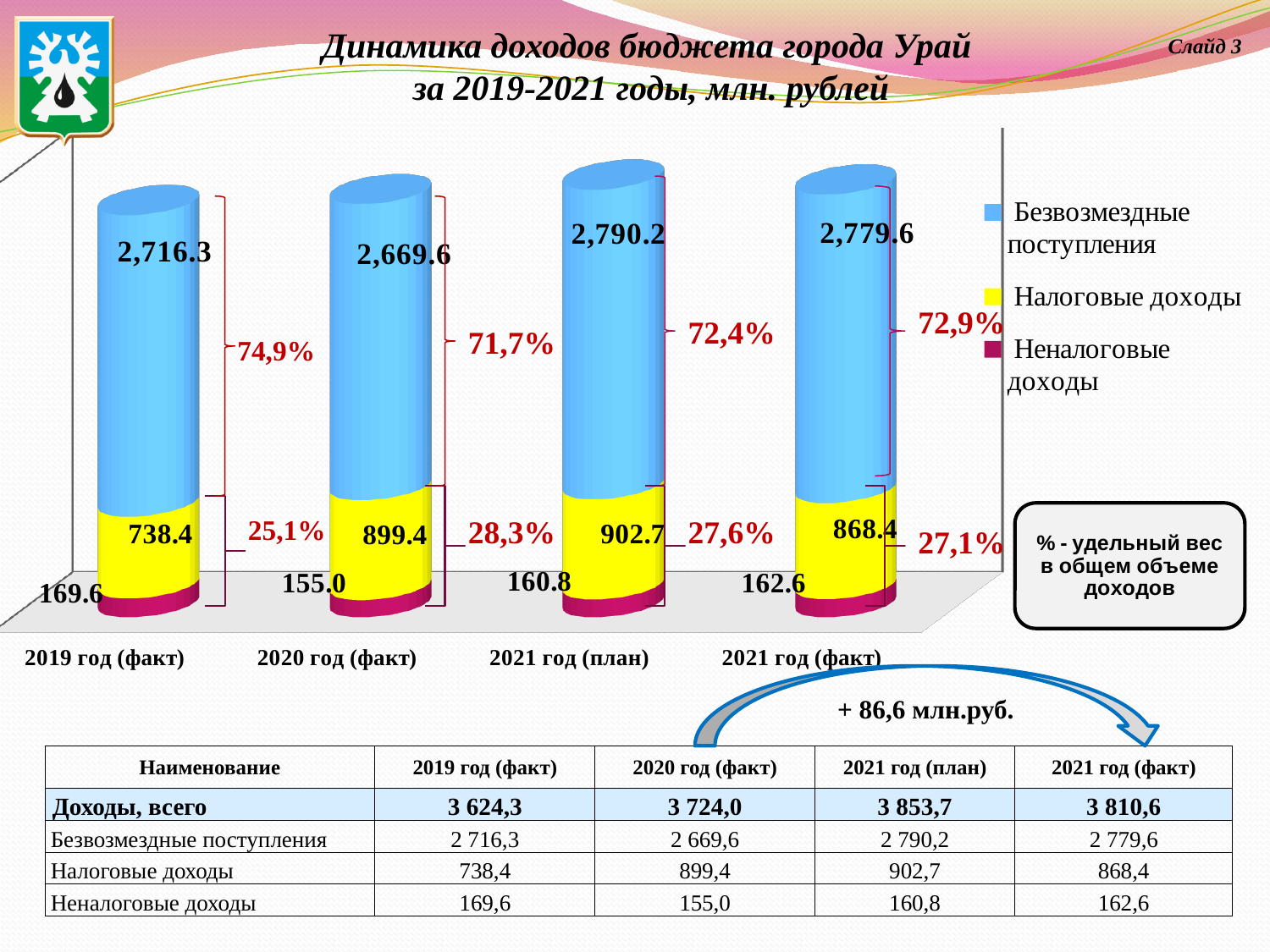
Which category has the lowest value for Налоговые доходы? 2019 год (факт) How many series does the legend list? 3 What colour represents Налоговые доходы in the legend? Yellow Which category has the highest value for Безвозмездные поступления? 2021 год (план) What is the value of Неналоговые доходы for 2021 год (план)? 160.8 What is the difference between Налоговые доходы in 2020 год (факт) and 2019 год (факт)? 161.0 How many categories are shown on the x axis of the chart? 4 What is the total of the stacked bar for 2021 год (факт)? 3 810,6 Which is larger: Неналоговые доходы in 2019 год (факт) or in 2021 год (факт)? 2019 год (факт) What kind of chart is shown on the slide? Stacked bar chart What is the value of Налоговые доходы for 2020 год (факт)? 899.4 What is the value of Безвозмездные поступления for 2019 год (факт)? 2,716.3